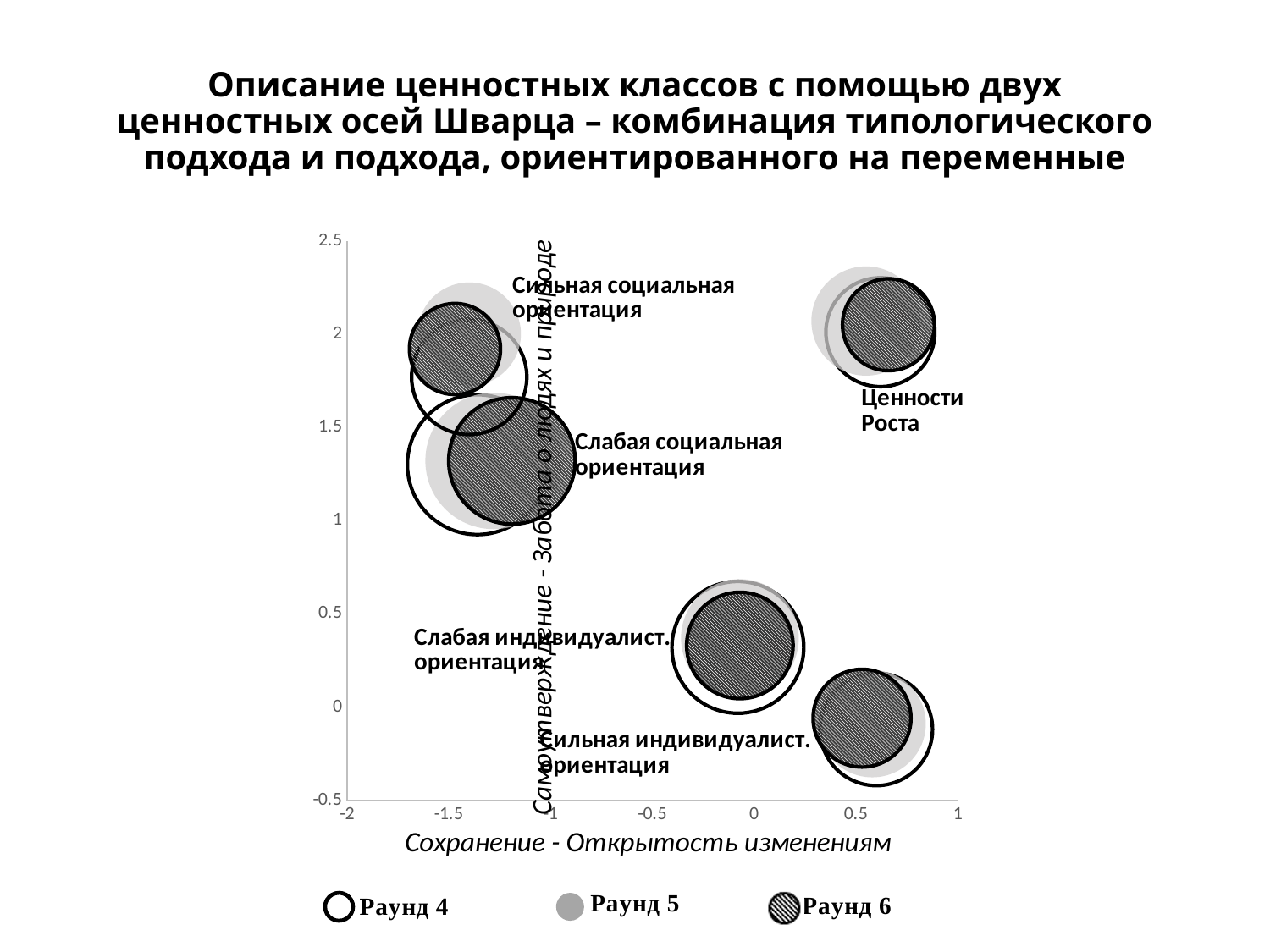
What kind of chart is shown on the slide? bubble chart Is the vertical-axis value for Сильная индивидуалист. ориентация greater or less than 0.5? less Is the vertical-axis value for Ценности Роста greater or less than 1.5? greater What is the label of the horizontal axis? Сохранение - Открытость изменениям How many value classes are labelled on the chart? 5 How many series does the legend list? 3 Which value class is lowest on the vertical axis? Сильная индивидуалист. ориентация Is the horizontal-axis value for Слабая индивидуалист. ориентация greater or less than 0.5? less Which is higher on the vertical axis, Ценности Роста or Сильная индивидуалист. ориентация? Ценности Роста Which series are listed in the legend? Раунд 4, Раунд 5, Раунд 6 Which is further right on the horizontal axis, Ценности Роста or Слабая социальная ориентация? Ценности Роста